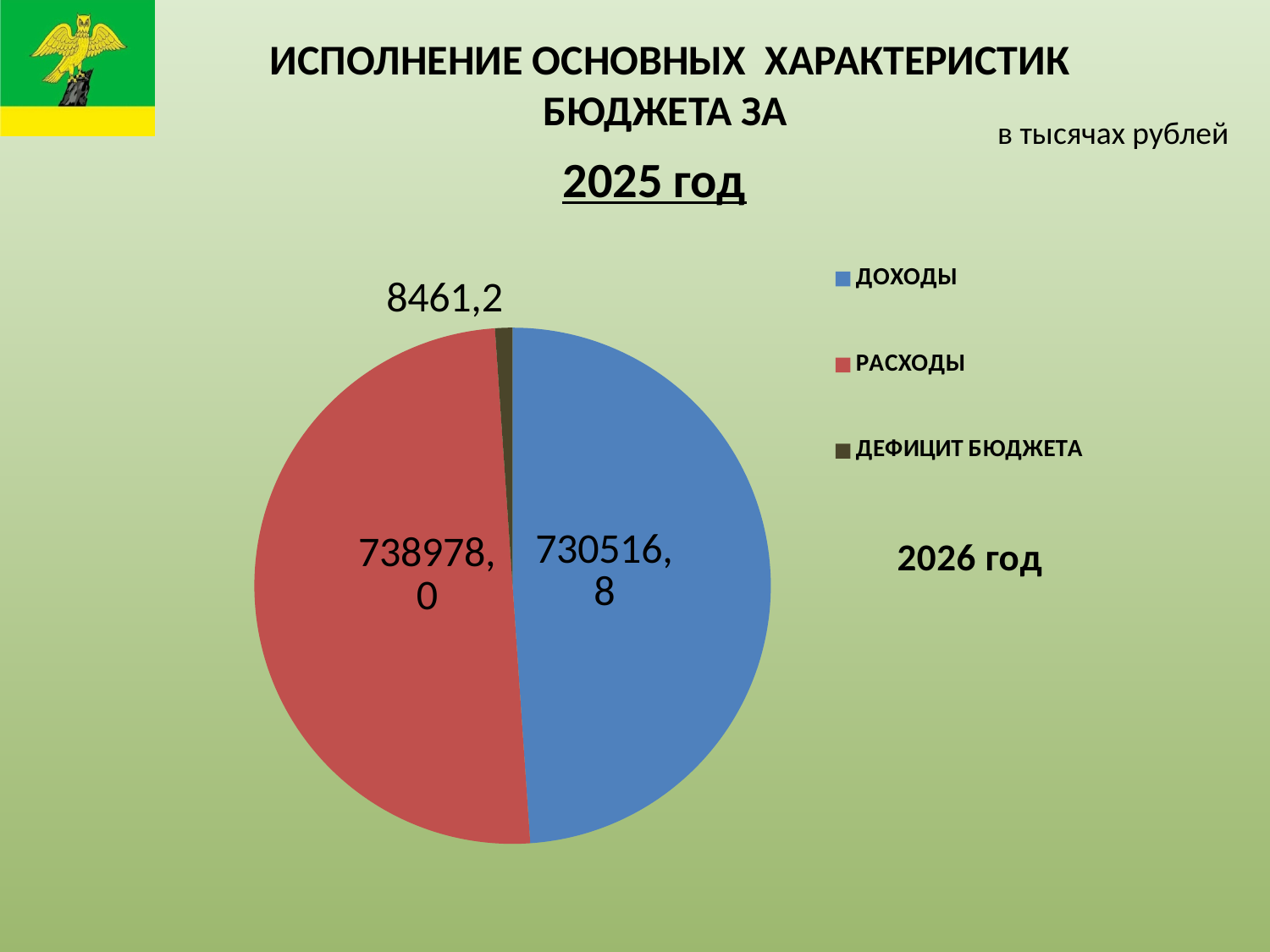
In what units are the chart values given, according to the slide? в тысячах рублей Which is larger, the value for ДОХОДЫ or the value for РАСХОДЫ? РАСХОДЫ What value is shown for РАСХОДЫ on the pie chart? 738978,0 Which category has the smallest slice of the pie chart? ДЕФИЦИТ БЮДЖЕТА What kind of chart is shown on the slide? pie chart What value is shown for ДЕФИЦИТ БЮДЖЕТА on the pie chart? 8461,2 What colour is the slice for ДОХОДЫ? blue Which category has the largest slice of the pie chart? РАСХОДЫ What is the difference between the values for РАСХОДЫ and ДОХОДЫ? 8461,2 How many slices does the pie chart have? 3 How many entries does the legend list? 3 What value is shown for ДОХОДЫ on the pie chart? 730516,8